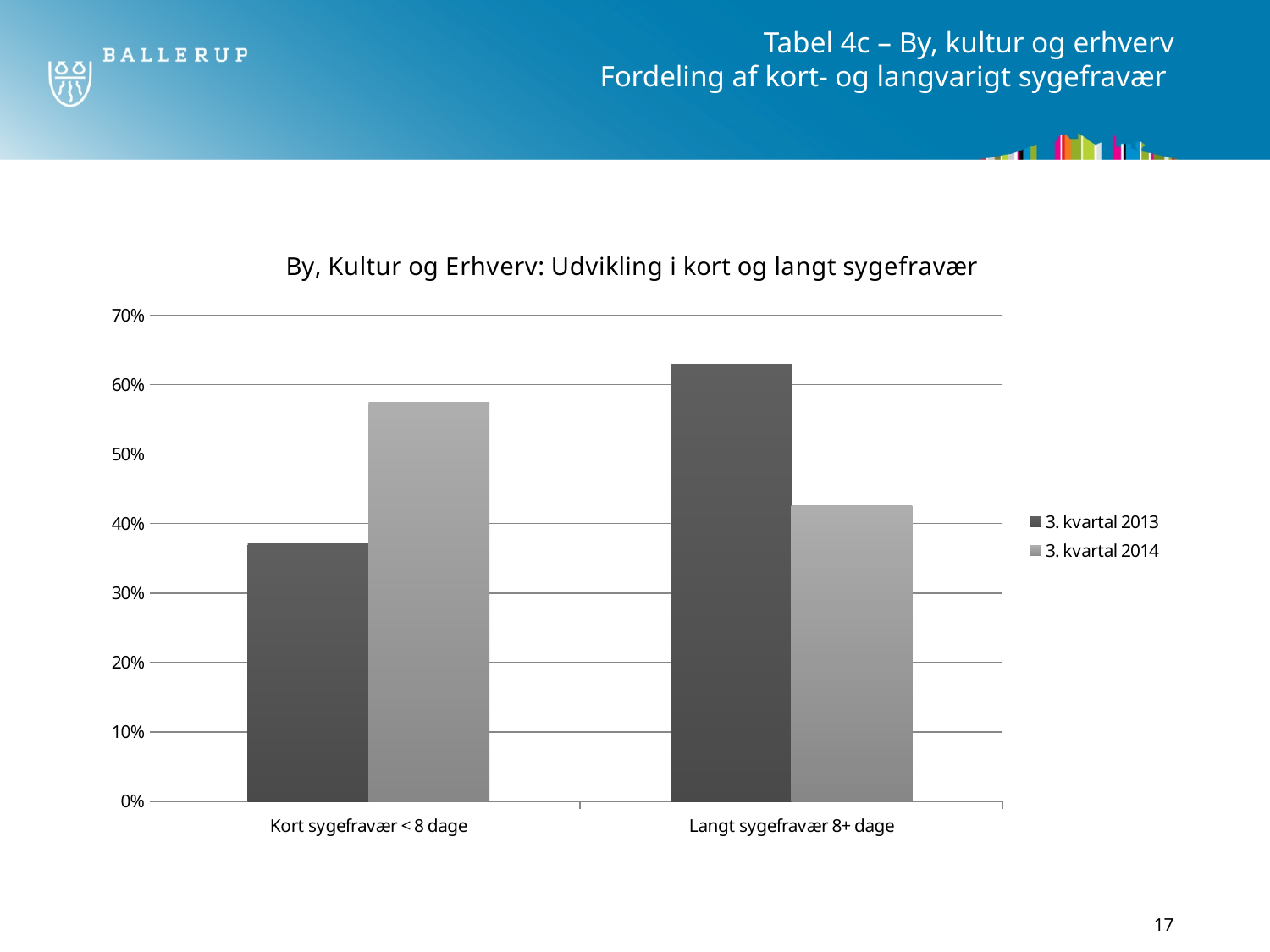
Is the value for Langt sygefravær 8+ dage in 3. kvartal 2014 greater or less than 50%? less Is the value for Kort sygefravær < 8 dage in 3. kvartal 2014 greater or less than 50%? greater Which is larger for Langt sygefravær 8+ dage: 3. kvartal 2013 or 3. kvartal 2014? 3. kvartal 2013 Is the value for Kort sygefravær < 8 dage in 3. kvartal 2013 greater or less than 40%? less How many categories are shown on the x axis? 2 What kind of chart is shown on the slide? bar chart Which is larger for Kort sygefravær < 8 dage: 3. kvartal 2013 or 3. kvartal 2014? 3. kvartal 2014 What is the title of the chart? By, Kultur og Erhverv: Udvikling i kort og langt sygefravær Which category has the lowest value for 3. kvartal 2014? Langt sygefravær 8+ dage Which category has the highest value for 3. kvartal 2013? Langt sygefravær 8+ dage How many series does the legend list? 2